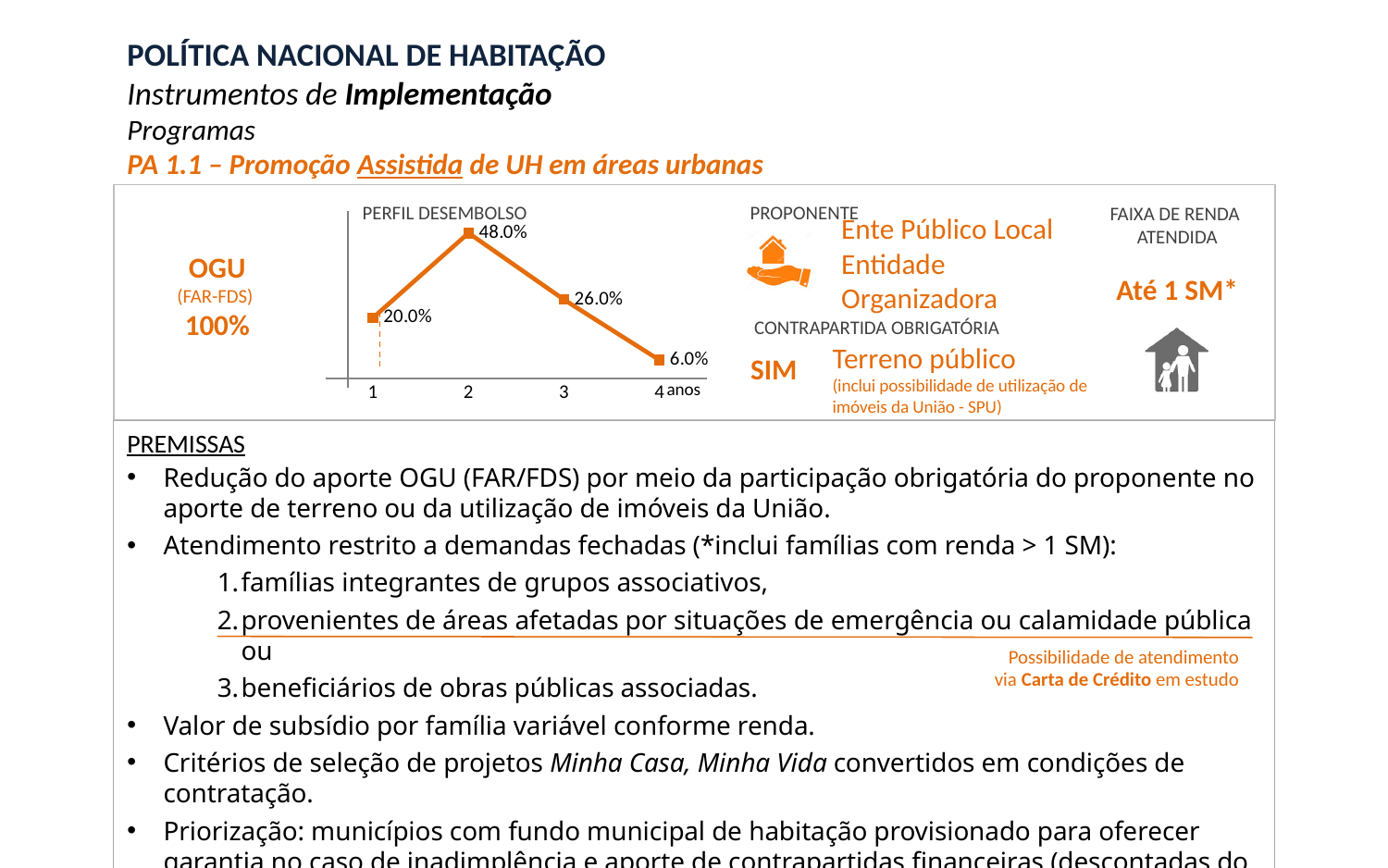
Which year has the highest value in the PERFIL DESEMBOLSO chart? 2 Which year has the lowest value in the PERFIL DESEMBOLSO chart? 4 How many data points are plotted in the PERFIL DESEMBOLSO chart? 4 What is the value for year 3 in the PERFIL DESEMBOLSO chart? 26.0% In the PERFIL DESEMBOLSO chart, do the values rise or fall from year 2 to year 4? fall What is the difference between the values for year 2 and year 3 in the PERFIL DESEMBOLSO chart? 22.0% What is the difference between the values for year 1 and year 4 in the PERFIL DESEMBOLSO chart? 14.0% What is the value for year 4 in the PERFIL DESEMBOLSO chart? 6.0% In the PERFIL DESEMBOLSO chart, which is larger, the value for year 1 or the value for year 3? year 3 What is the value for year 2 in the PERFIL DESEMBOLSO chart? 48.0% What kind of chart is the PERFIL DESEMBOLSO chart? line chart What is the value for year 1 in the PERFIL DESEMBOLSO chart? 20.0%